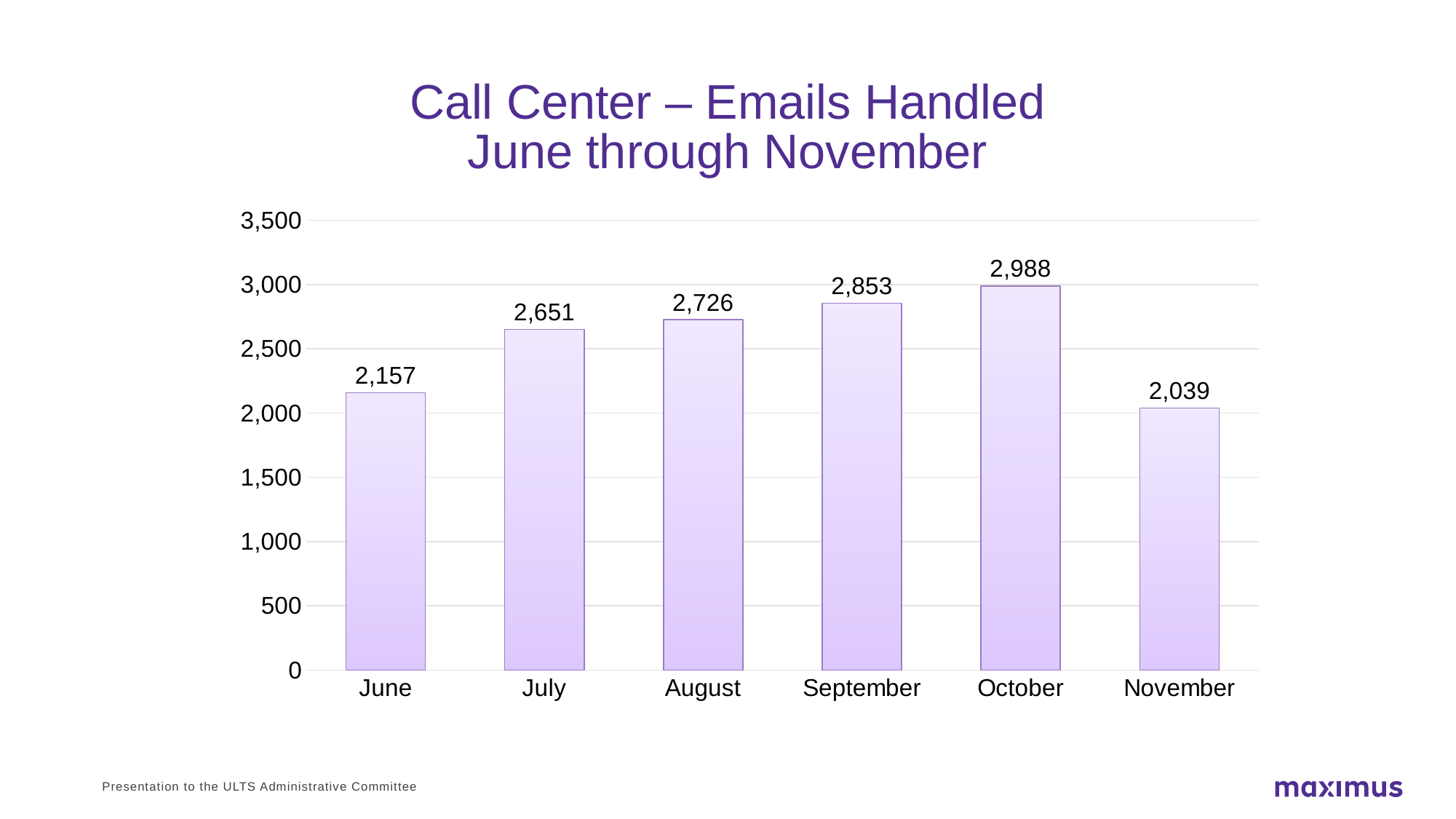
Which is larger, the value for June or the value for November? June What is the value shown for September? 2,853 What is the difference between the values for August and July? 75 Is the value for October greater or less than 2,500? greater How many emails were handled in November? 2,039 What kind of chart is shown on the slide? Bar chart Which month has the highest number of emails handled? October How many emails were handled in June? 2,157 Which month has the lowest number of emails handled? November What is the title of the chart? Call Center – Emails Handled June through November What is the difference between the values for October and November? 949 How many months are shown on the chart? 6